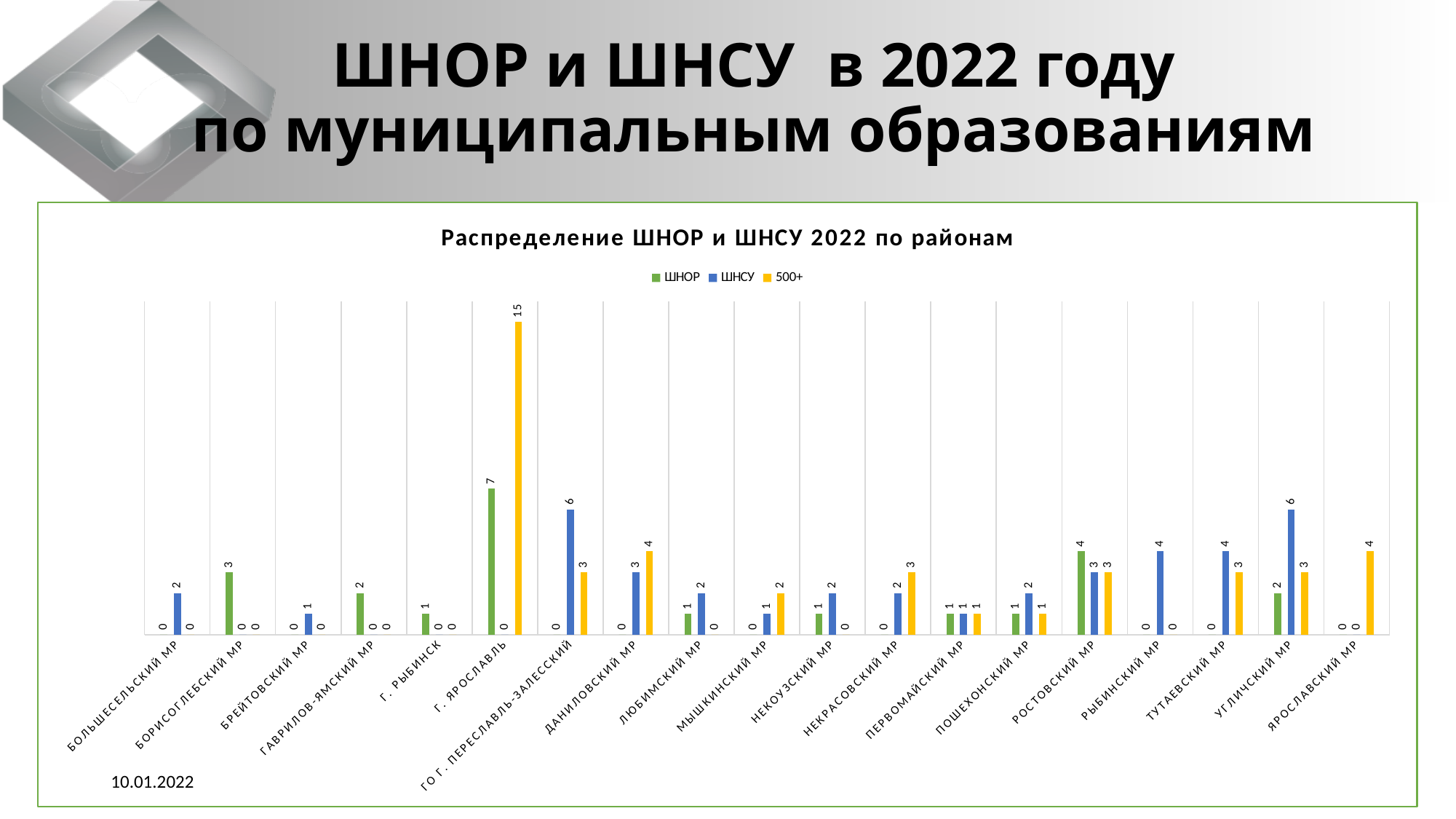
Which municipality has the highest ШНОР value? г. Ярославль What kind of chart is shown on the slide? Bar chart How many series does the legend list? 3 What is the difference between the 500+ value and the ШНОР value for г. Ярославль? 8 What is the ШНОР value for Борисоглебский МР? 3 What is the ШНСУ value for Угличский МР? 6 Which municipality has the highest 500+ value? г. Ярославль What is the title of the chart? Распределение ШНОР и ШНСУ 2022 по районам What is the total of the three values for Ростовский МР? 10 How many municipalities are shown on the x axis? 19 For Ростовский МР, which is larger: the ШНОР value or the ШНСУ value? ШНОР What is the 500+ value for г. Ярославль? 15